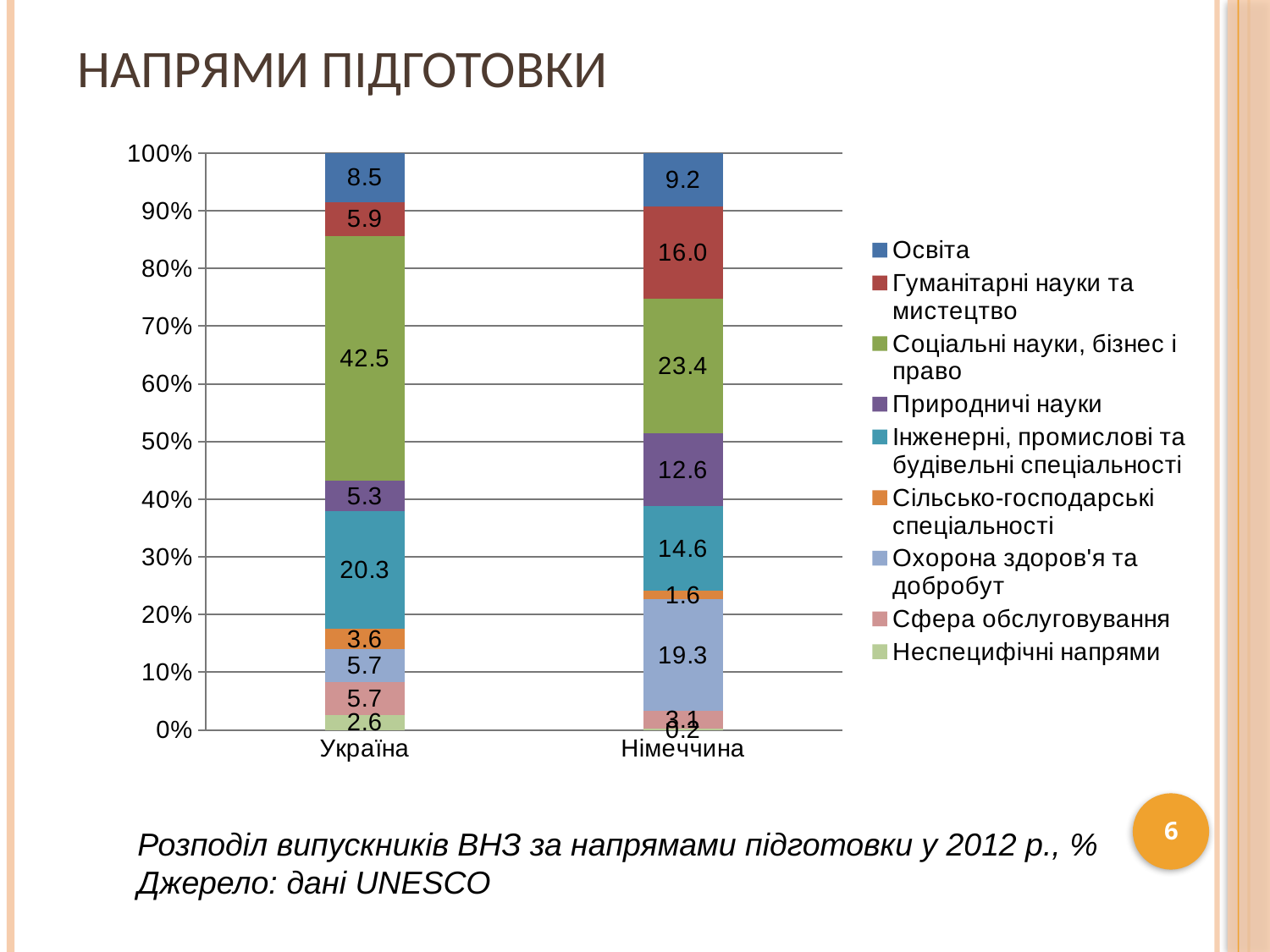
What is the value for Інженерні, промислові та будівельні спеціальності for Україна? 20.3 Which country is shown in the left bar of the chart? Україна How many countries (categories) are shown on the x axis? 2 What is the value for Соціальні науки, бізнес і право for Україна? 42.5 What kind of chart is shown on the slide? stacked bar chart Which series has the smallest value in the Україна bar? Неспецифічні напрями How many series does the legend list? 9 Which country has the larger value for Природничі науки, Україна or Німеччина? Німеччина What is the value for Гуманітарні науки та мистецтво for Німеччина? 16.0 Which series has the largest value in the Україна bar? Соціальні науки, бізнес і право What is the difference between the Соціальні науки, бізнес і право values for Україна and Німеччина? 19.1 What is the value for Охорона здоров'я та добробут for Німеччина? 19.3